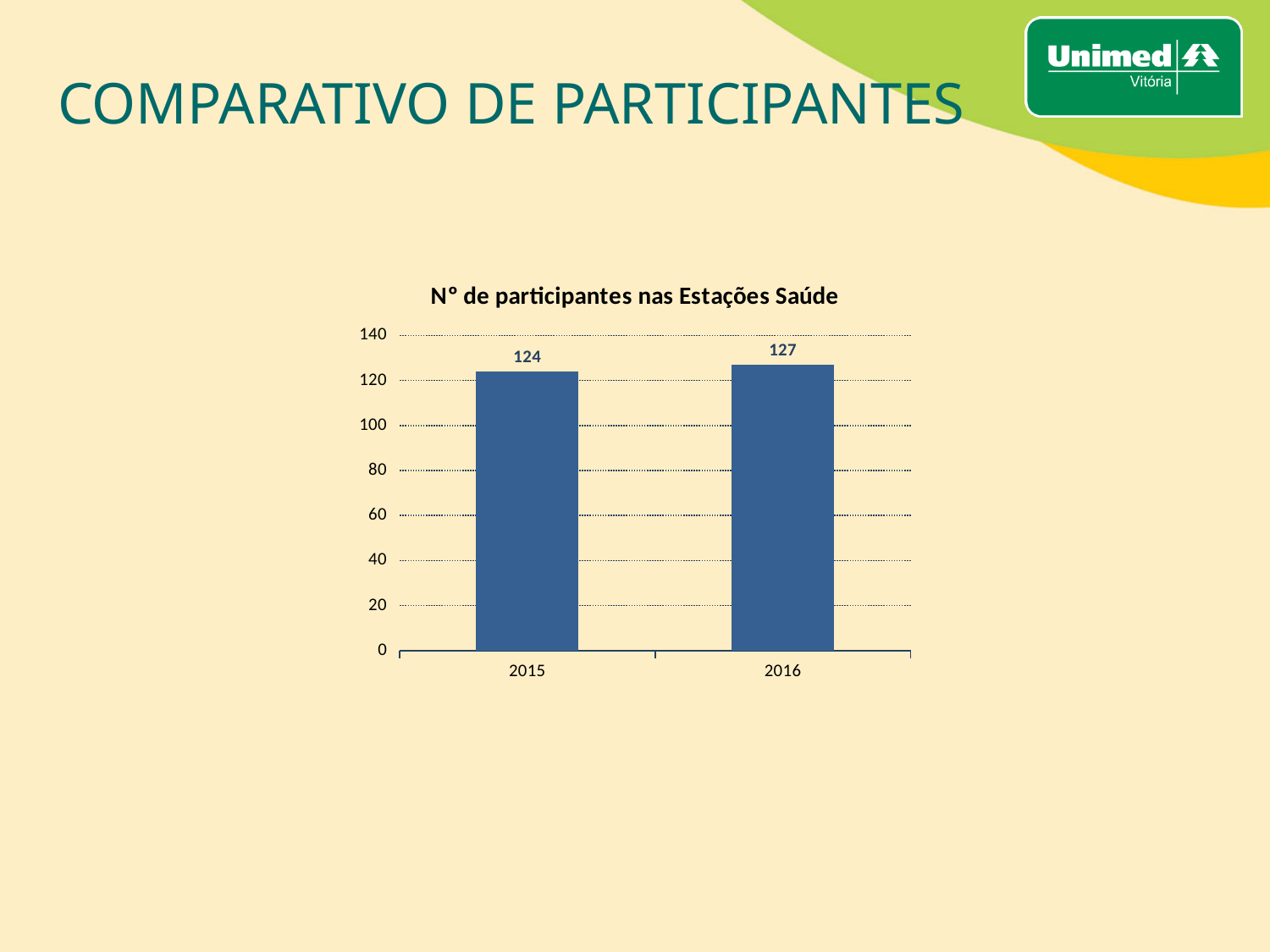
Which year has the lower number of participants? 2015 What is the title of the chart? N° de participantes nas Estações Saúde Is the value for 2015 greater or less than 120? greater How many years are shown on the x axis? 2 What is the highest value shown on the y axis? 140 Which year has the higher number of participants? 2016 Is the value for 2016 greater or less than 140? less What kind of chart is shown on the slide? bar chart What is the number of participants in 2015? 124 What is the number of participants in 2016? 127 Do the values rise or fall from 2015 to 2016? rise What is the difference in participants between 2016 and 2015? 3